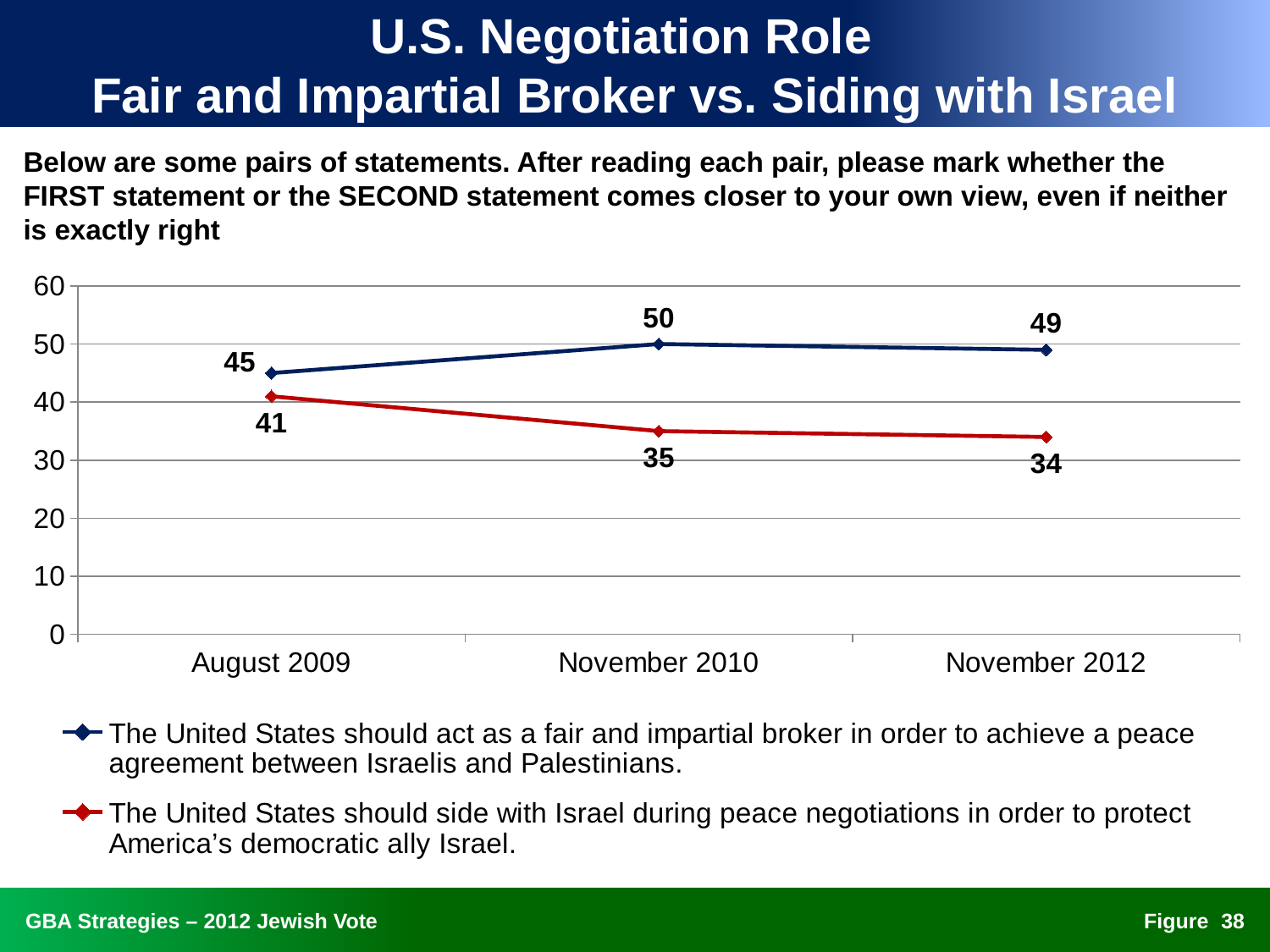
What is the value for the 'side with Israel' series in November 2012? 34 Which series has the larger value in August 2009? The United States should act as a fair and impartial broker In which survey wave is the 'side with Israel' series lowest? November 2012 What is the difference between the two series in November 2012? 15 In which survey wave is the 'fair and impartial broker' series highest? November 2010 What colour is the line for the 'side with Israel' series? red What kind of chart is shown on the slide? line chart What is the value for the 'side with Israel' series in August 2009? 41 How many time points are plotted on the x axis? 3 Does the 'side with Israel' series rise or fall from August 2009 to November 2012? fall How many series does the legend list? 2 What is the value for the 'fair and impartial broker' series in November 2010? 50